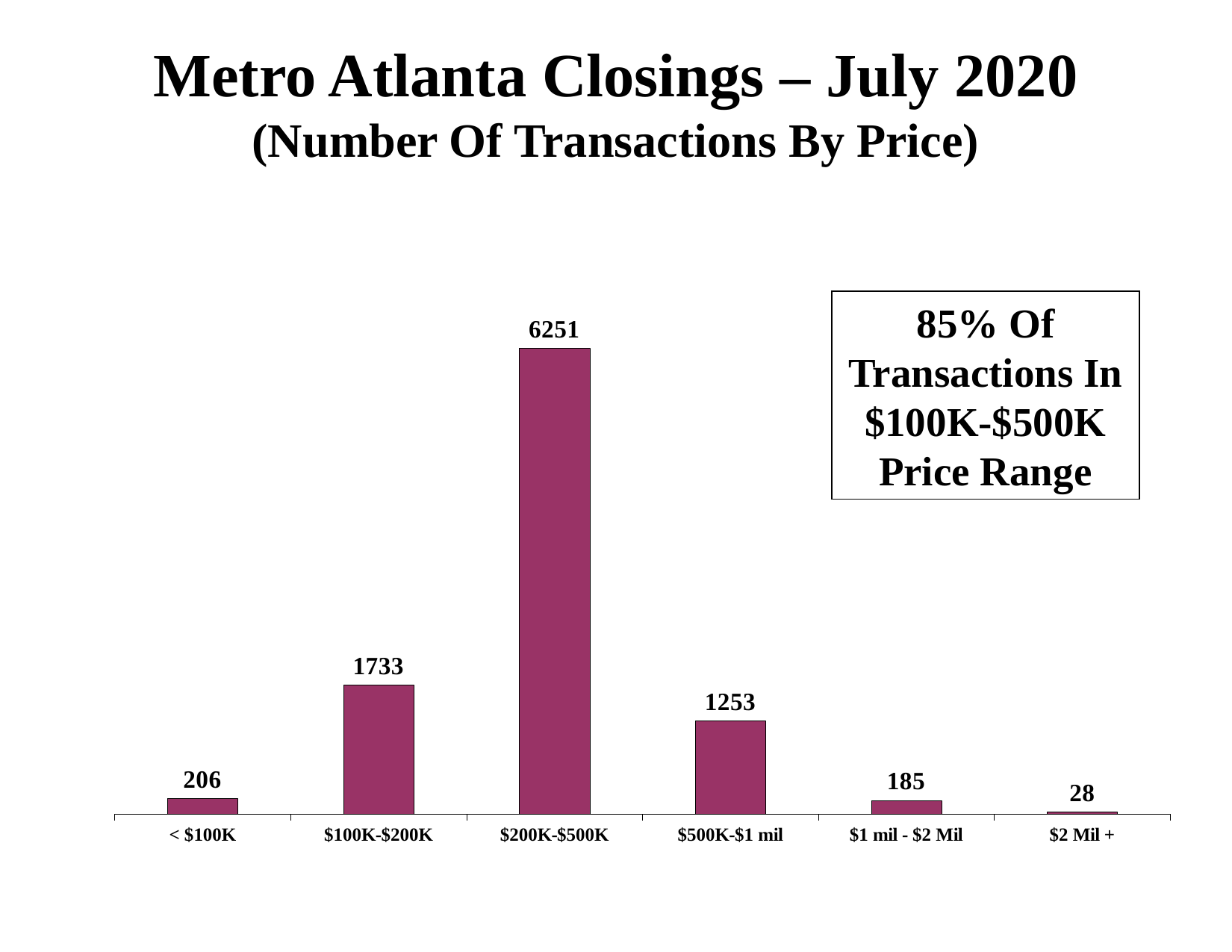
What is the difference between the $200K-$500K and $100K-$200K transaction counts? 4518 How many price range categories are shown on the chart? 6 What is the difference in transactions between the $100K-$200K and $500K-$1 mil ranges? 480 What type of chart is shown on the slide? Bar chart Which price range has the lowest number of transactions? $2 Mil + What is the total number of transactions in the $100K-$200K and $200K-$500K ranges combined? 7984 Which price range has the highest number of transactions? $200K-$500K According to the text box on the slide, what percentage of transactions are in the $100K-$500K price range? 85% Which has more transactions, < $100K or $1 mil - $2 Mil? < $100K How many transactions were in the $1 mil - $2 Mil range? 185 What is the number of transactions for the < $100K category? 206 How many transactions were in the $200K-$500K price range? 6251